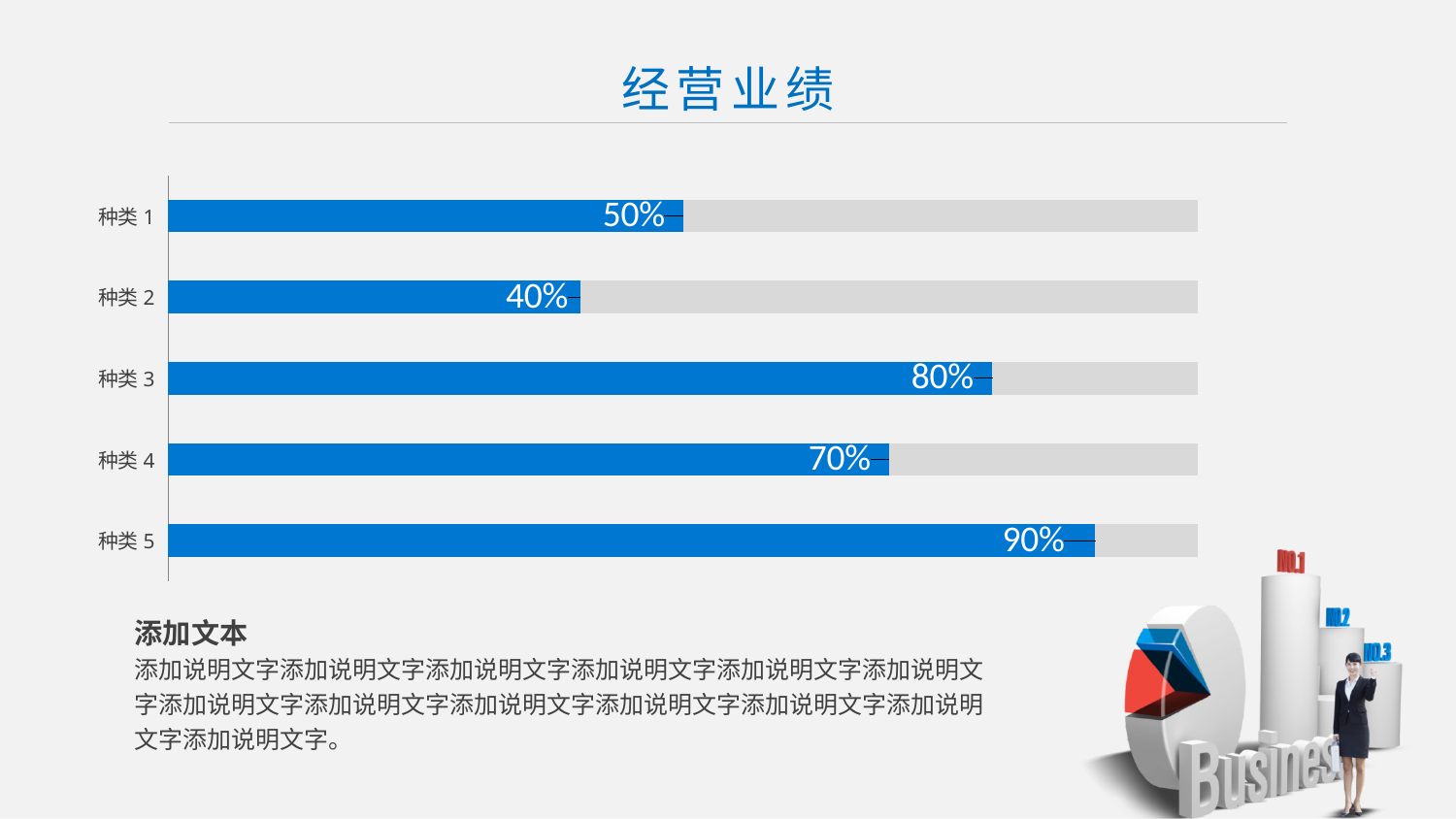
What colour are the bars in the chart? blue What is the value for 种类 1? 50% What is the difference between the values for 种类 5 and 种类 2? 50% How many categories are shown in the chart? 5 Which is larger, the value for 种类 1 or the value for 种类 4? 种类 4 Which category has the highest value? 种类 5 What kind of chart is shown on the slide? bar chart What is the value for 种类 3? 80% What is the difference between the values for 种类 3 and 种类 4? 10% What is the title of the slide containing the chart? 经营业绩 What is the value for 种类 5? 90% Which category has the lowest value? 种类 2